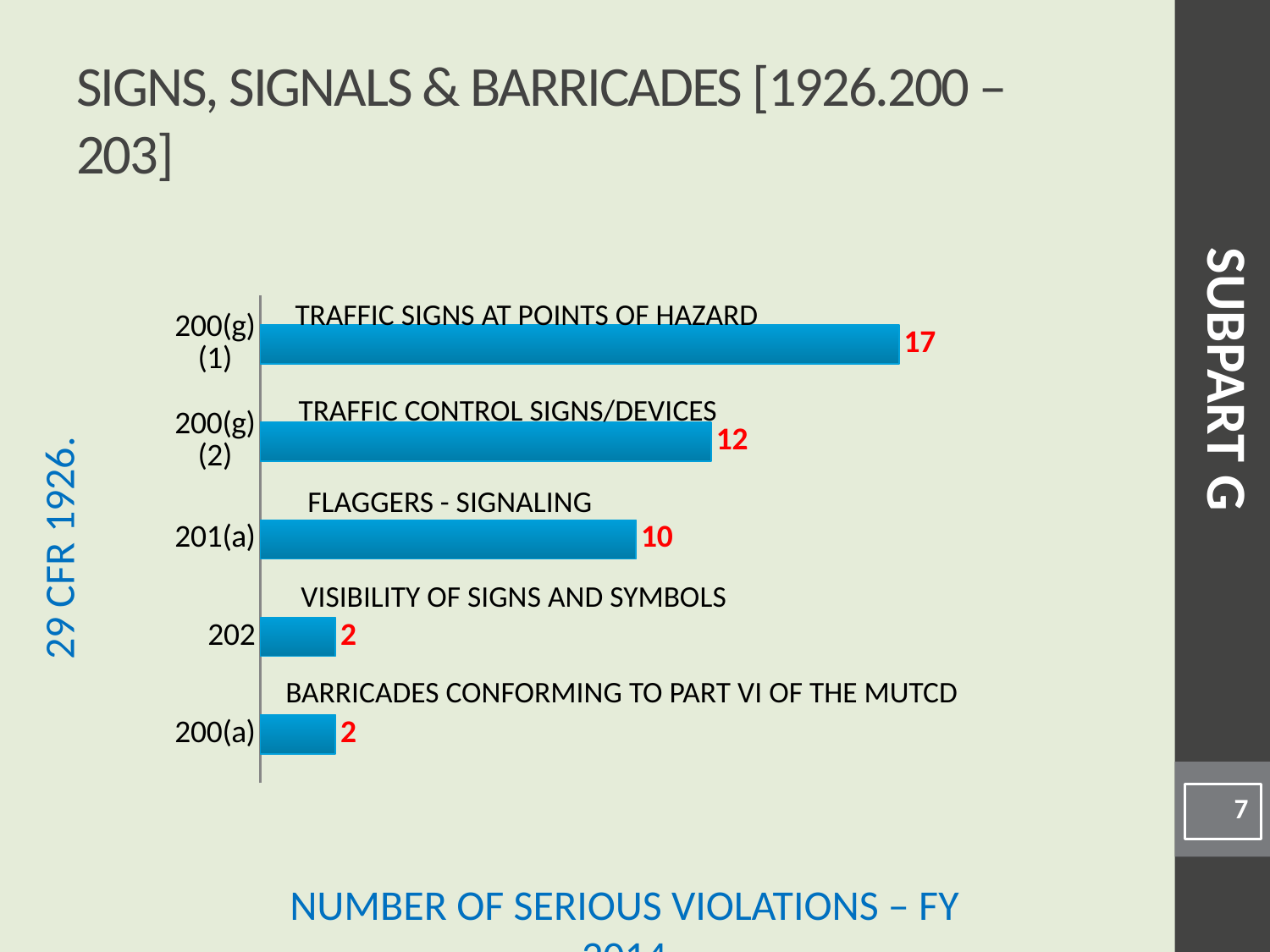
What is the number of serious violations for 200(g)(2), Traffic Control Signs/Devices? 12 What is the total number of serious violations across all five categories shown? 43 What is the number of serious violations for 201(a), Flaggers - Signaling? 10 What is the difference in serious violations between 201(a) and 202? 8 What is the number of serious violations for 200(g)(1), Traffic Signs at Points of Hazard? 17 Which has more serious violations, 200(g)(2) or 201(a)? 200(g)(2) How many categories are shown in the chart? 5 What is the difference in serious violations between 200(g)(1) and 200(g)(2)? 5 Which category has the highest number of serious violations? 200(g)(1) Traffic Signs at Points of Hazard What kind of chart is shown on the slide? Bar chart What colour are the bars in the chart? Blue What is the number of serious violations for 202, Visibility of Signs and Symbols? 2